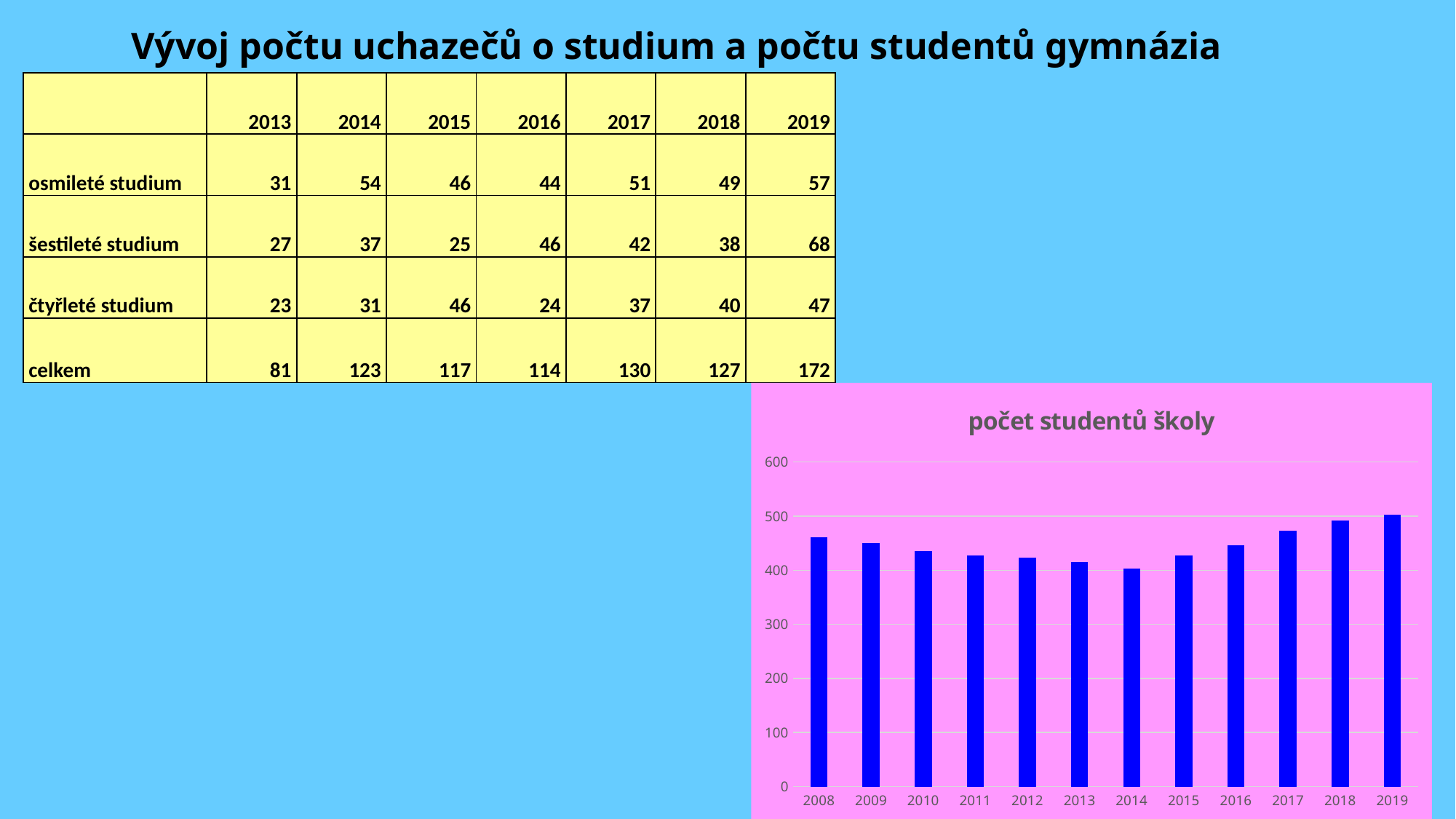
Do the values rise or fall from 2014 to 2019? rise Is the value for 2008 greater or less than 400? greater Which year has the highest bar in the chart? 2019 Which is larger, the value for 2008 or the value for 2014? 2008 What is the title of the chart on the slide? počet studentů školy Which is larger, the value for 2012 or the value for 2017? 2017 How many years are shown on the x axis of the chart? 12 What is the highest value shown on the y axis of the chart? 600 Which year has the lowest bar in the chart? 2014 Is the value for 2014 greater or less than 500? less What type of chart is shown on the slide? bar chart Is the value for 2013 greater or less than 300? greater